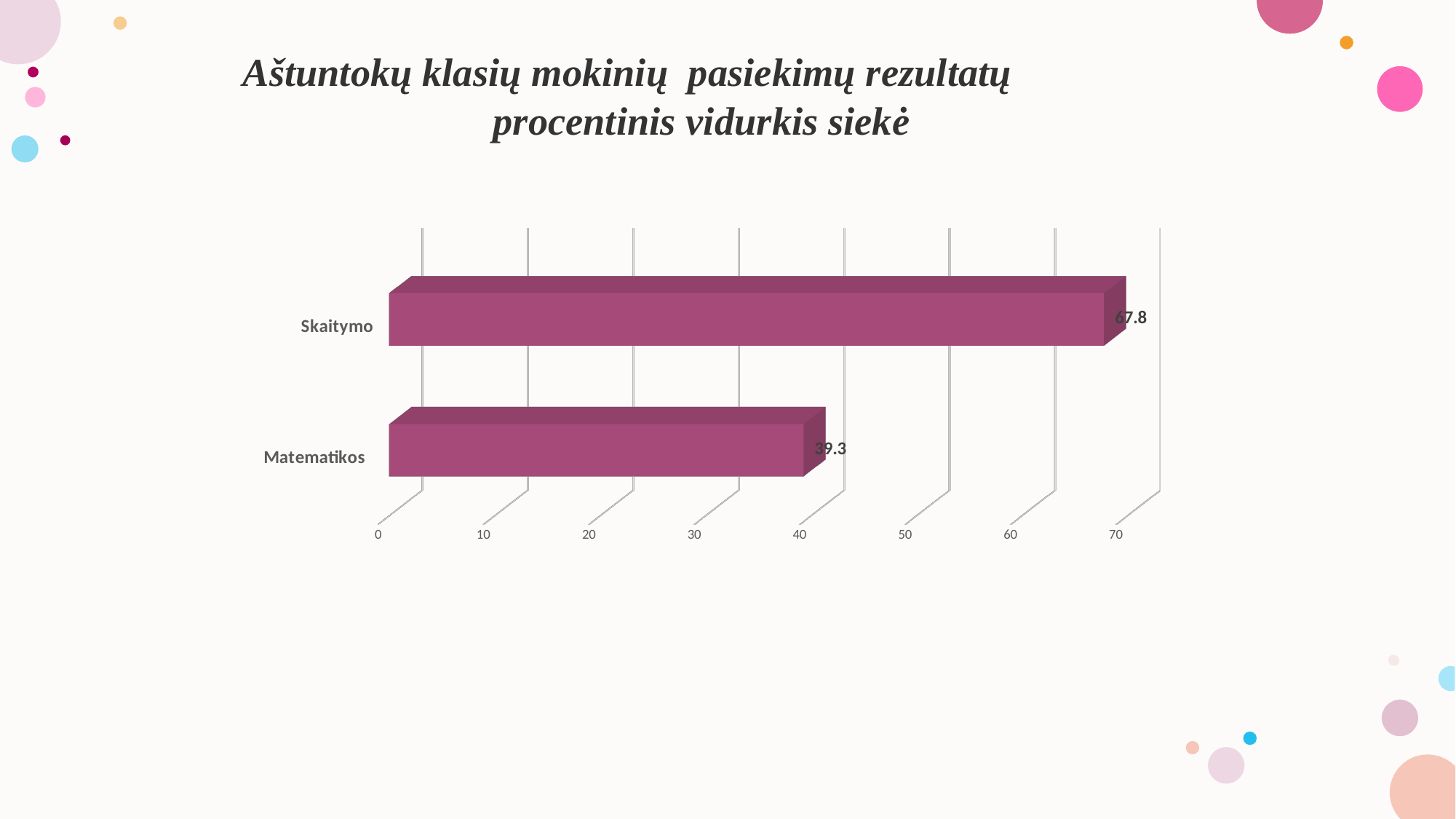
Is the value for Skaitymo greater or less than 60? greater What is the title of the chart on the slide? Aštuntokų klasių mokinių pasiekimų rezultatų procentinis vidurkis siekė What kind of chart is shown on the slide? bar chart Which is larger, the value for Skaitymo or the value for Matematikos? Skaitymo Which category has the highest value? Skaitymo Which category has the lowest value? Matematikos What is the value for Matematikos? 39.3 Is the value for Matematikos greater or less than 40? less What is the value for Skaitymo? 67.8 What is the difference between the values for Skaitymo and Matematikos? 28.5 What is the highest value shown on the horizontal axis? 70 How many categories are shown in the chart? 2